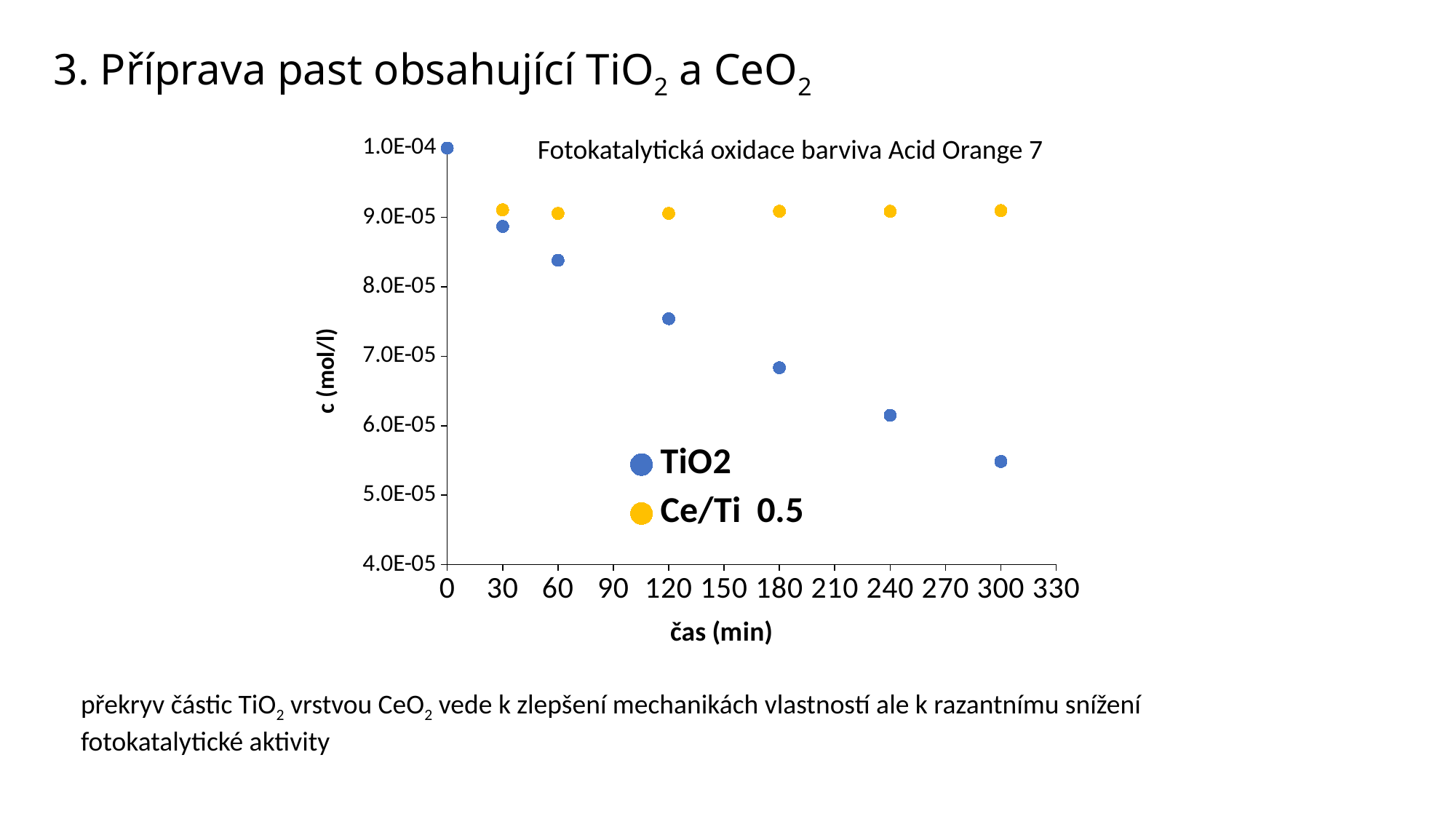
Is the value for TiO2 at 120 min greater or less than 7.0E-05? greater How many series does the legend list? 2 What is the label of the x axis? čas (min) Is the value for TiO2 at 60 min greater or less than 8.0E-05? greater At which time does the TiO2 series have its highest value? 0 What is the value of the TiO2 series at time 0 min? 1.0E-04 What kind of chart is shown on the slide? scatter chart Do the TiO2 values rise or fall as time increases? fall At 300 min, which series has the higher value, TiO2 or Ce/Ti 0.5? Ce/Ti 0.5 What is the title of the chart? Fotokatalytická oxidace barviva Acid Orange 7 Is the value for TiO2 at 300 min greater or less than 6.0E-05? less At which time does the TiO2 series reach its lowest value? 300